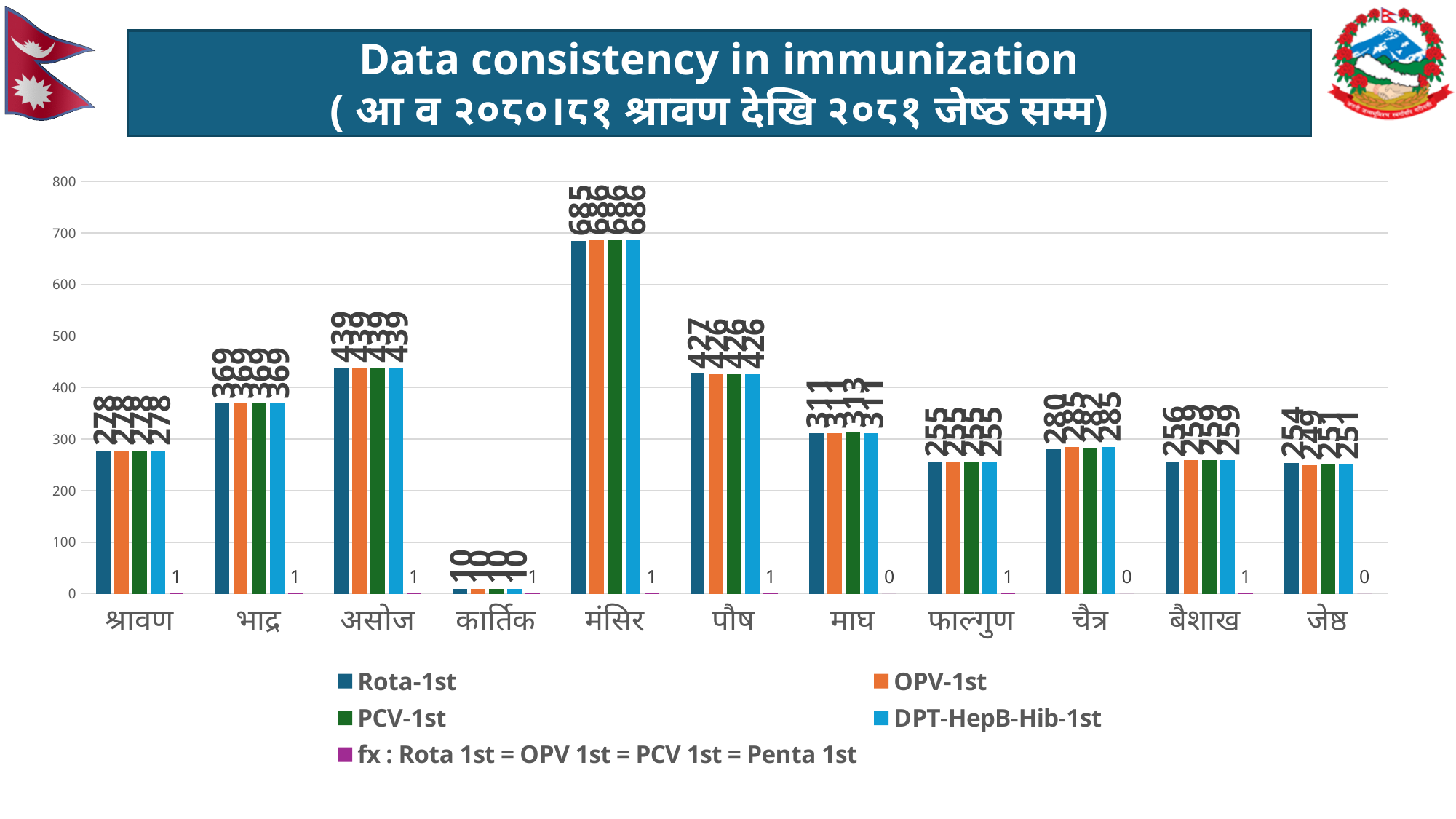
Is the Rota-1st value for पौष greater or less than 400? greater How many month categories are shown along the x axis of the chart? 11 What is the English title of the chart on the slide? Data consistency in immunization Which month has the highest bars in the chart? मंसिर Which month has larger Rota-1st bars, असोज or भाद्र? असोज What kind of chart is shown on the slide? bar chart Is the Rota-1st value for कार्तिक greater or less than 100? less Is the Rota-1st value for श्रावण greater or less than 300? less How many series does the chart's legend list? 5 Which month has the lowest bars in the chart? कार्तिक What is the value of the 'fx : Rota 1st = OPV 1st = PCV 1st = Penta 1st' series for माघ? 0